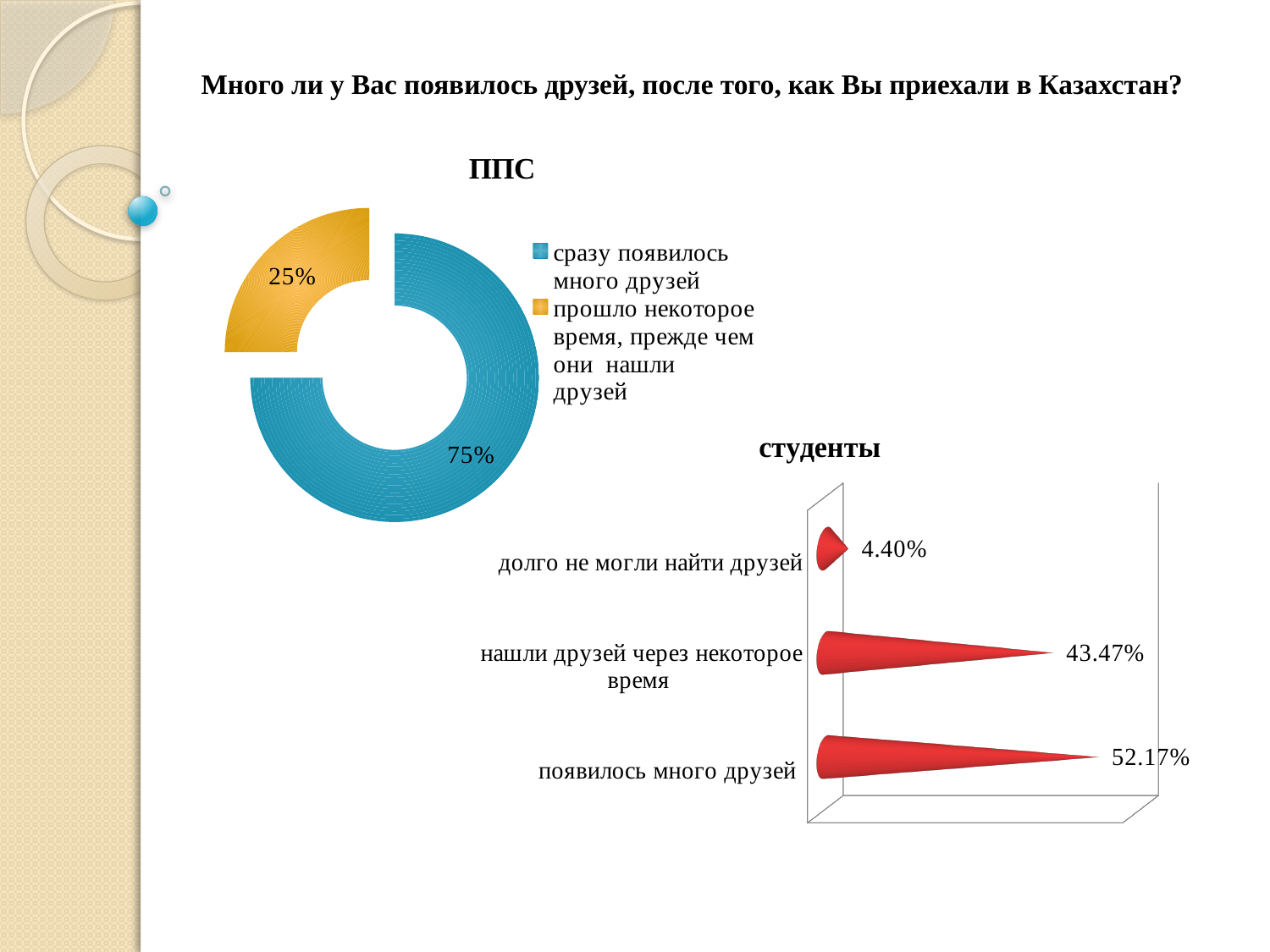
What kind of chart is the "студенты" chart? bar chart In the "студенты" chart, what is the value for "долго не могли найти друзей"? 4.40% In the "студенты" chart, which category has the lowest value? долго не могли найти друзей In the "студенты" chart, what is the value for "нашли друзей через некоторое время"? 43.47% What kind of chart is the "ППС" chart? doughnut chart How many entries does the legend of the "ППС" chart list? 2 In the "студенты" chart, what is the value for "появилось много друзей"? 52.17% In the "студенты" chart, how many categories are shown? 3 In the "ППС" chart, which category has the larger share? сразу появилось много друзей In the "ППС" chart, what share is labelled for "сразу появилось много друзей"? 75% In the "ППС" chart, what is the difference between the two shares? 50% In the "ППС" chart, what share is labelled for "прошло некоторое время, прежде чем они нашли друзей"? 25%